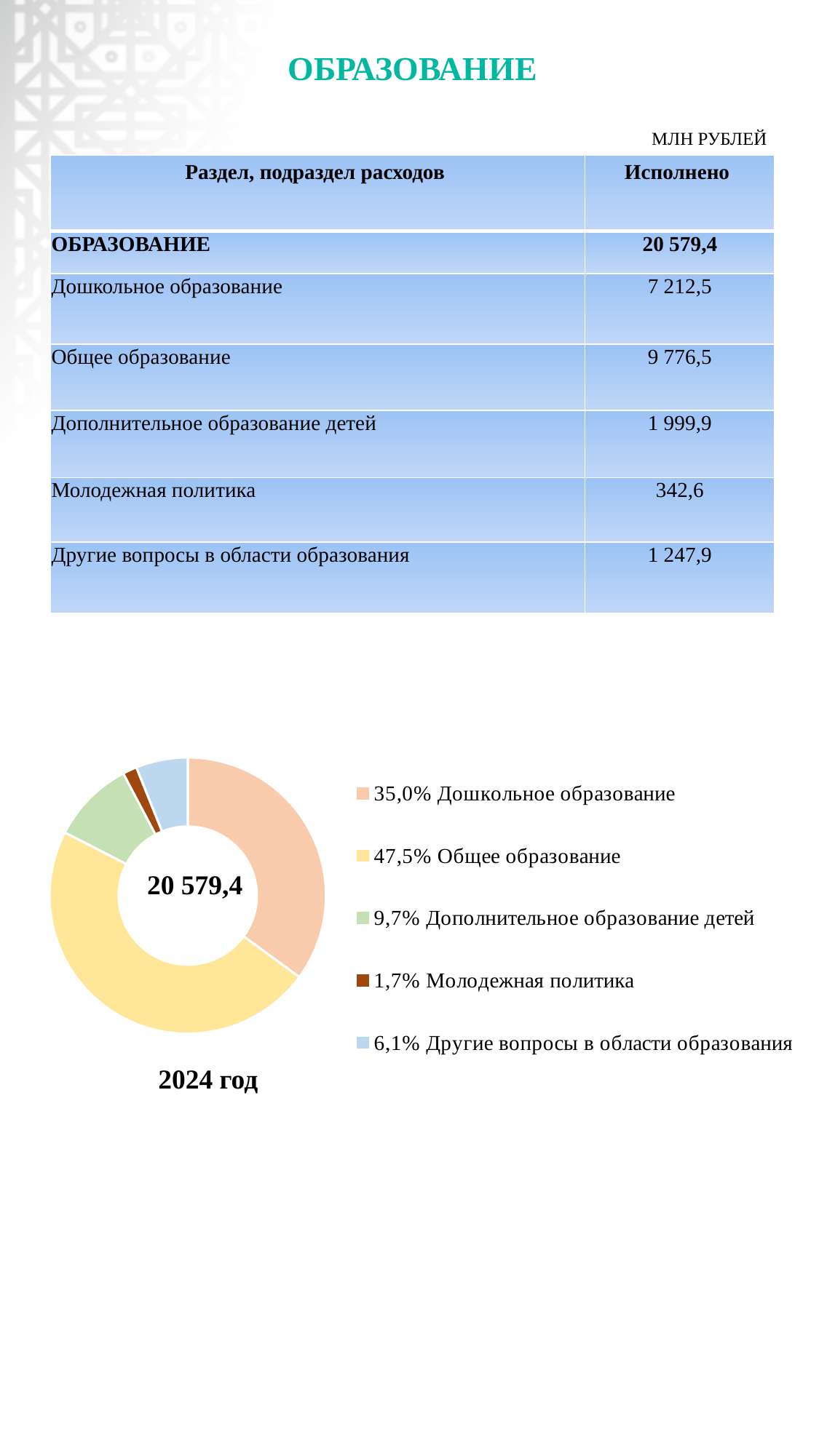
How many categories does the doughnut chart's legend list? 5 Which category has the smallest slice in the doughnut chart? Молодежная политика What total value is printed in the centre of the doughnut chart? 20 579,4 What share of the doughnut chart does Общее образование take? 47,5% What kind of chart is shown on the slide? Doughnut (pie) chart What is the difference in percentage points between the shares of Общее образование and Дошкольное образование in the doughnut chart? 12,5% What share of the doughnut chart does Другие вопросы в области образования take? 6,1% What share of the doughnut chart does Дошкольное образование take? 35,0% Which category has the largest slice in the doughnut chart? Общее образование Which slice is larger in the doughnut chart: Дополнительное образование детей or Другие вопросы в области образования? Дополнительное образование детей